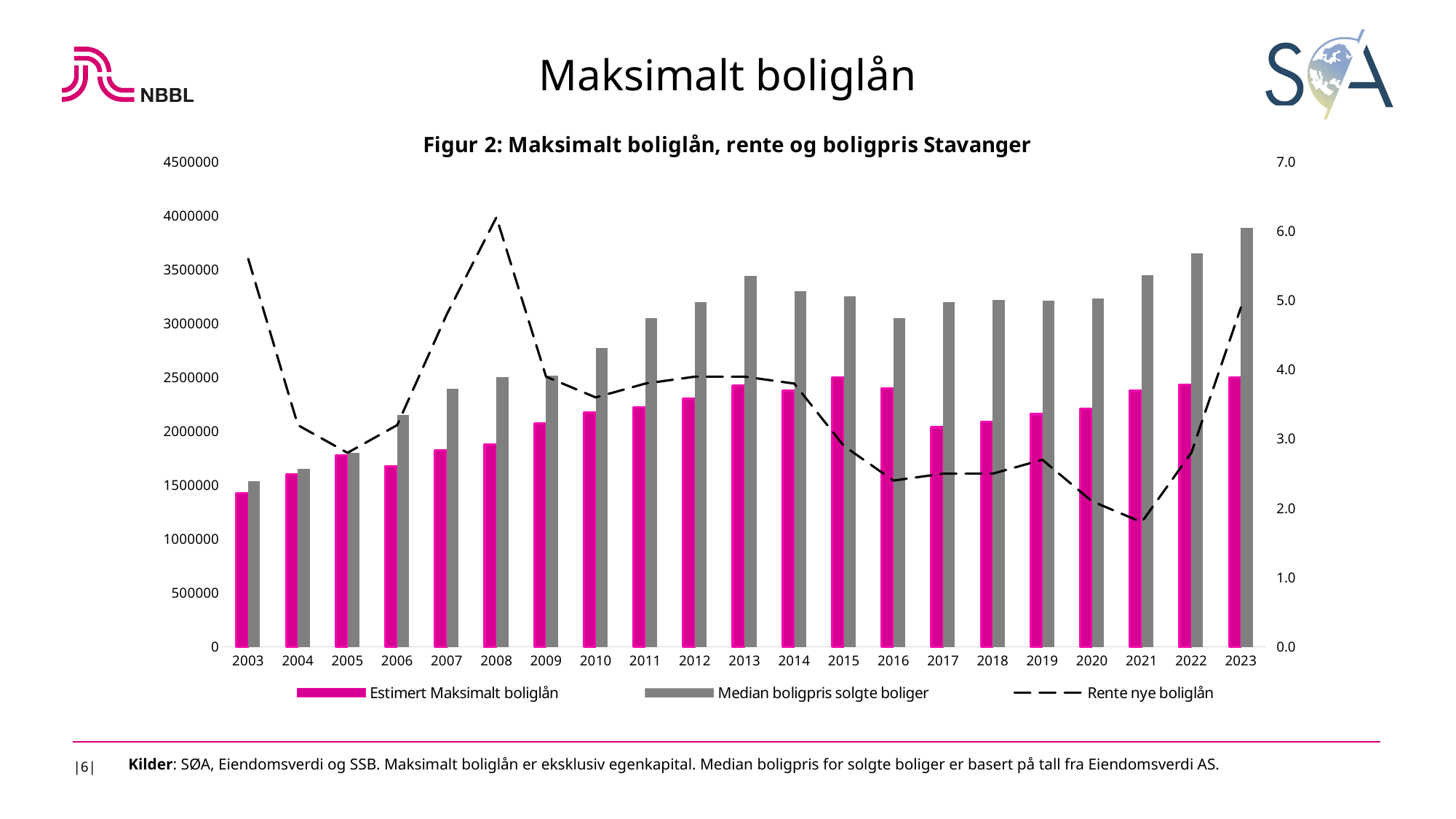
Is the value for Rente nye boliglån in 2021 greater or less than 2.0? less Which year has the highest value for Median boligpris solgte boliger? 2023 Which year has the lowest value for Estimert Maksimalt boliglån? 2003 What kind of chart is shown on the slide? A bar chart combined with a line Is the value for Estimert Maksimalt boliglån in 2003 greater or less than 1500000? less In which year does the Rente nye boliglån line reach its highest point? 2008 In which year does the Rente nye boliglån line reach its lowest point? 2021 How many years are shown on the x axis? 21 Which year has the lowest value for Median boligpris solgte boliger? 2003 How many series does the legend list? 3 Which is larger, Estimert Maksimalt boliglån in 2015 or in 2017? 2015 Is the value for Median boligpris solgte boliger in 2023 greater or less than 3500000? greater